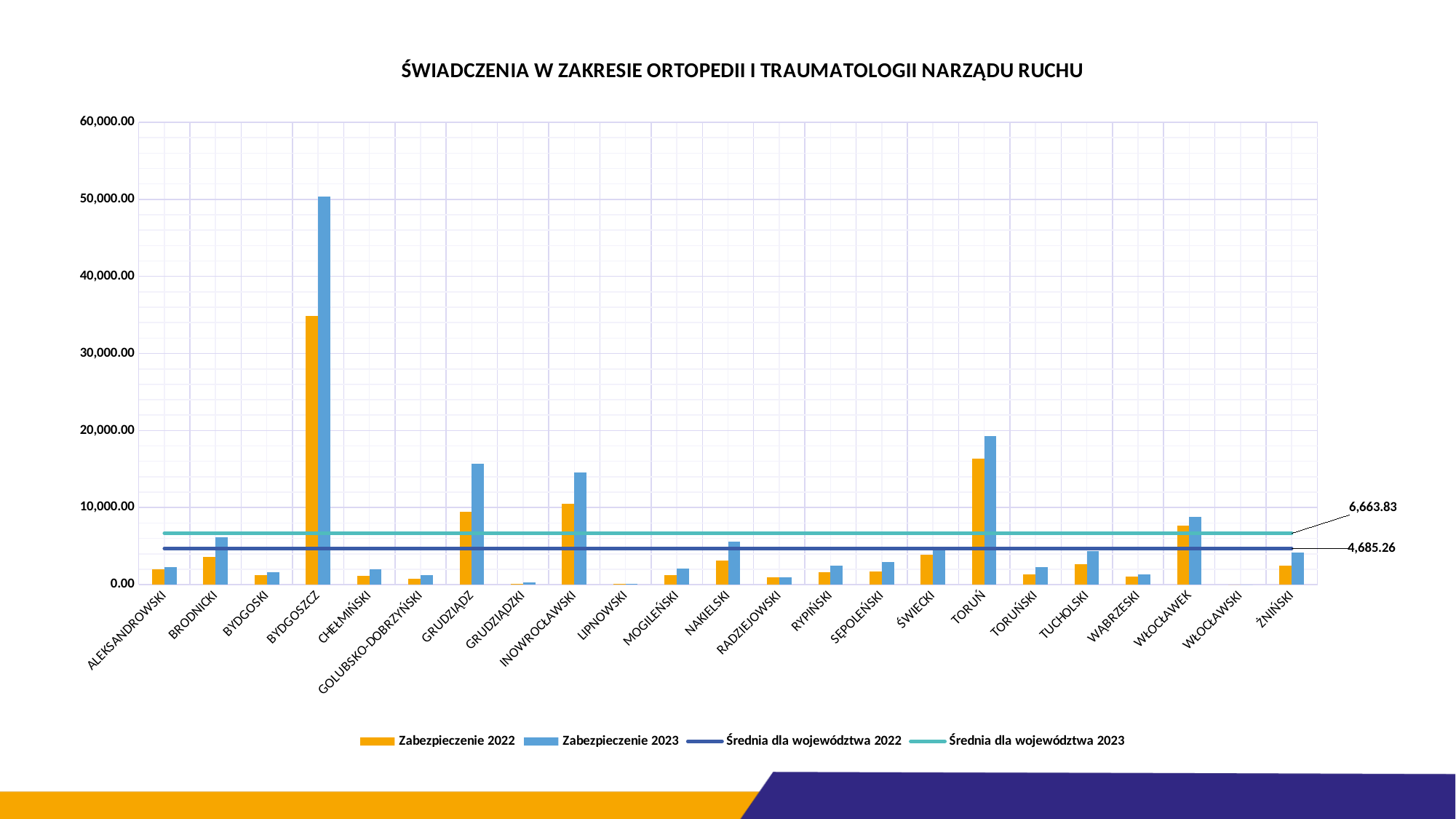
How many categories are shown on the x axis? 23 Which is larger for TORUŃ: the Zabezpieczenie 2022 value or the Zabezpieczenie 2023 value? Zabezpieczenie 2023 Which category has the highest Zabezpieczenie 2023 value? BYDGOSZCZ What kind of chart is shown on the slide? combination bar and line chart Which category has the highest Zabezpieczenie 2022 value? BYDGOSZCZ What is the value of the Średnia dla województwa 2023 line? 6,663.83 What is the title of the chart? ŚWIADCZENIA W ZAKRESIE ORTOPEDII I TRAUMATOLOGII NARZĄDU RUCHU What is the value of the Średnia dla województwa 2022 line? 4,685.26 Is the Zabezpieczenie 2023 value for TORUŃ greater or less than 20,000.00? less What is the difference between the Średnia dla województwa 2023 and Średnia dla województwa 2022 values? 1,978.57 Is the Zabezpieczenie 2023 value for BYDGOSZCZ greater or less than 40,000.00? greater How many entries does the legend list? 4